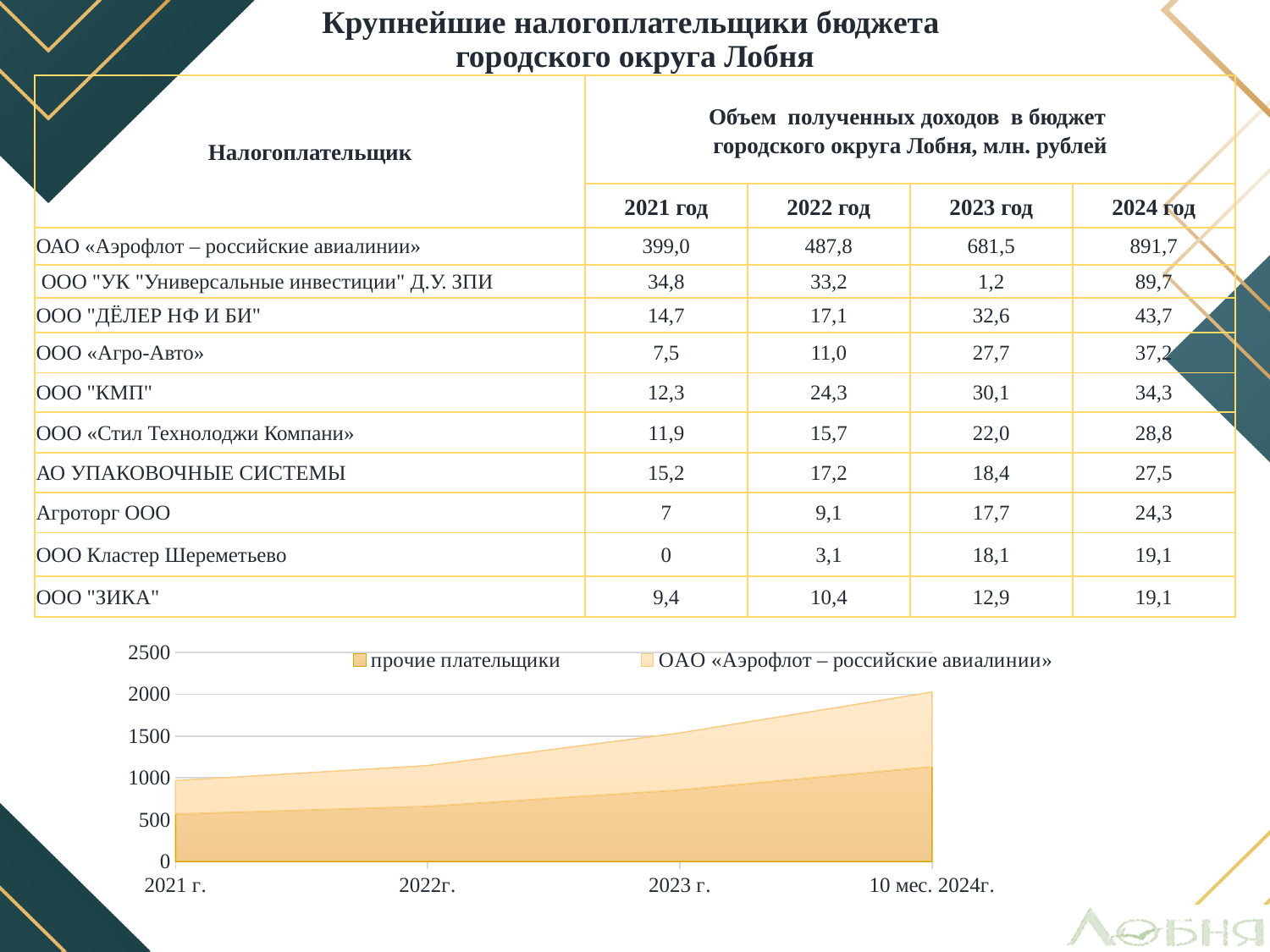
Is the combined (stacked) value at 2021 г. greater or less than 1500? less How many series does the legend of the chart list? 2 Which series is listed first in the chart legend? прочие плательщики What is the label of the last point on the x axis of the chart? 10 мес. 2024г. What kind of chart is shown at the bottom of the slide? area chart Does the total plotted value in the chart rise or fall from 2021 г. to 10 мес. 2024г.? rise Is the combined (stacked) value at 10 мес. 2024г. greater or less than 1500? greater Is the combined (stacked) value at 2023 г. greater or less than 1000? greater How many time points are plotted along the x axis of the chart? 4